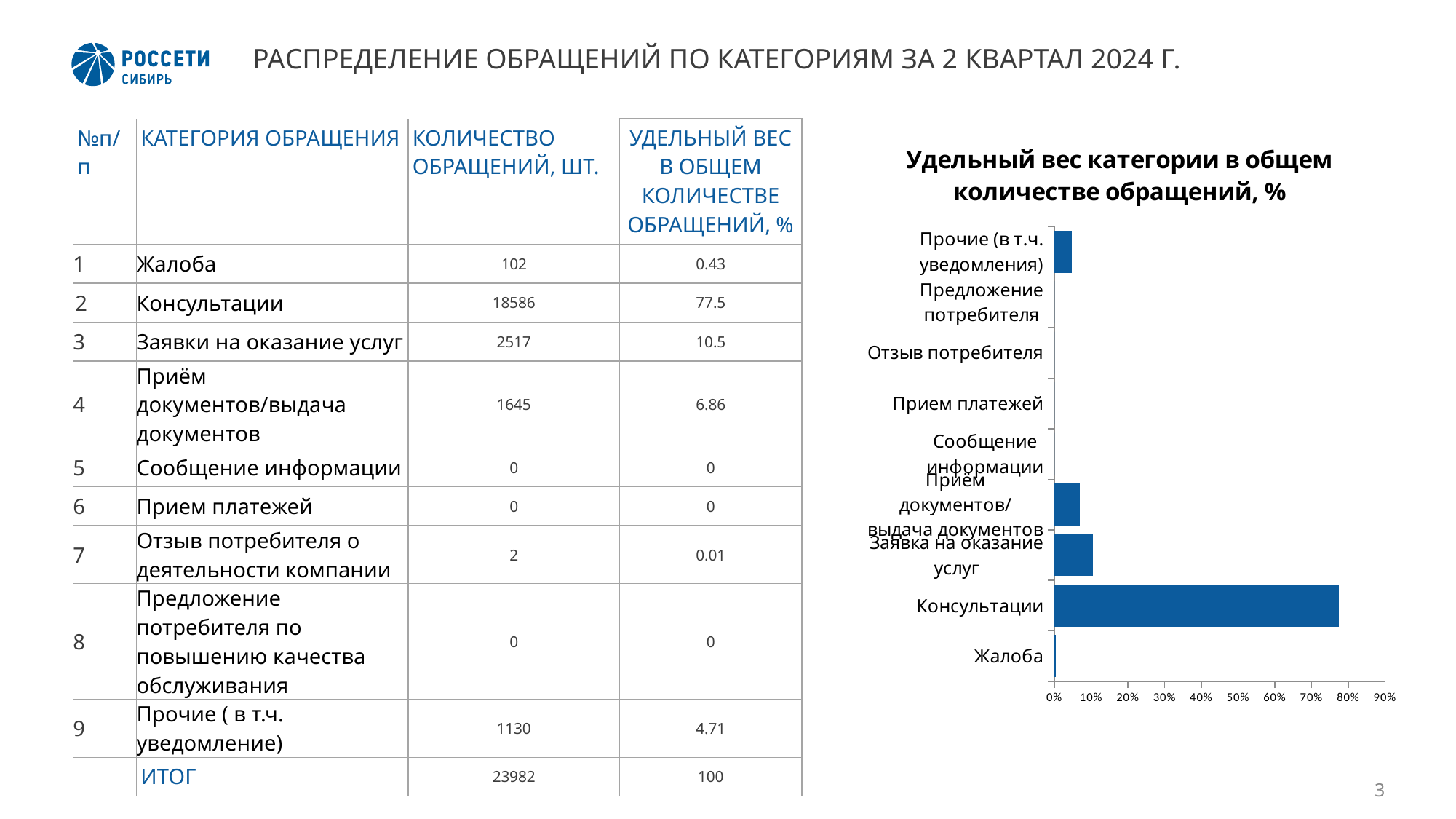
Is the value for Приём документов/выдача документов greater or less than 10%? less Which category has the highest share in the chart? Консультации How many categories are listed on the chart's vertical axis? 9 What is the title of the chart? Удельный вес категории в общем количестве обращений, % What kind of chart is shown on the slide? bar chart Which is larger: the value for Заявка на оказание услуг or the value for Приём документов/выдача документов? Заявка на оказание услуг Is the value for Консультации greater or less than 80%? less Is the value for Прочие (в т.ч. уведомления) greater or less than 10%? less Which is larger: the value for Консультации or the value for Жалоба? Консультации What is the highest percentage tick shown on the chart's horizontal axis? 90%